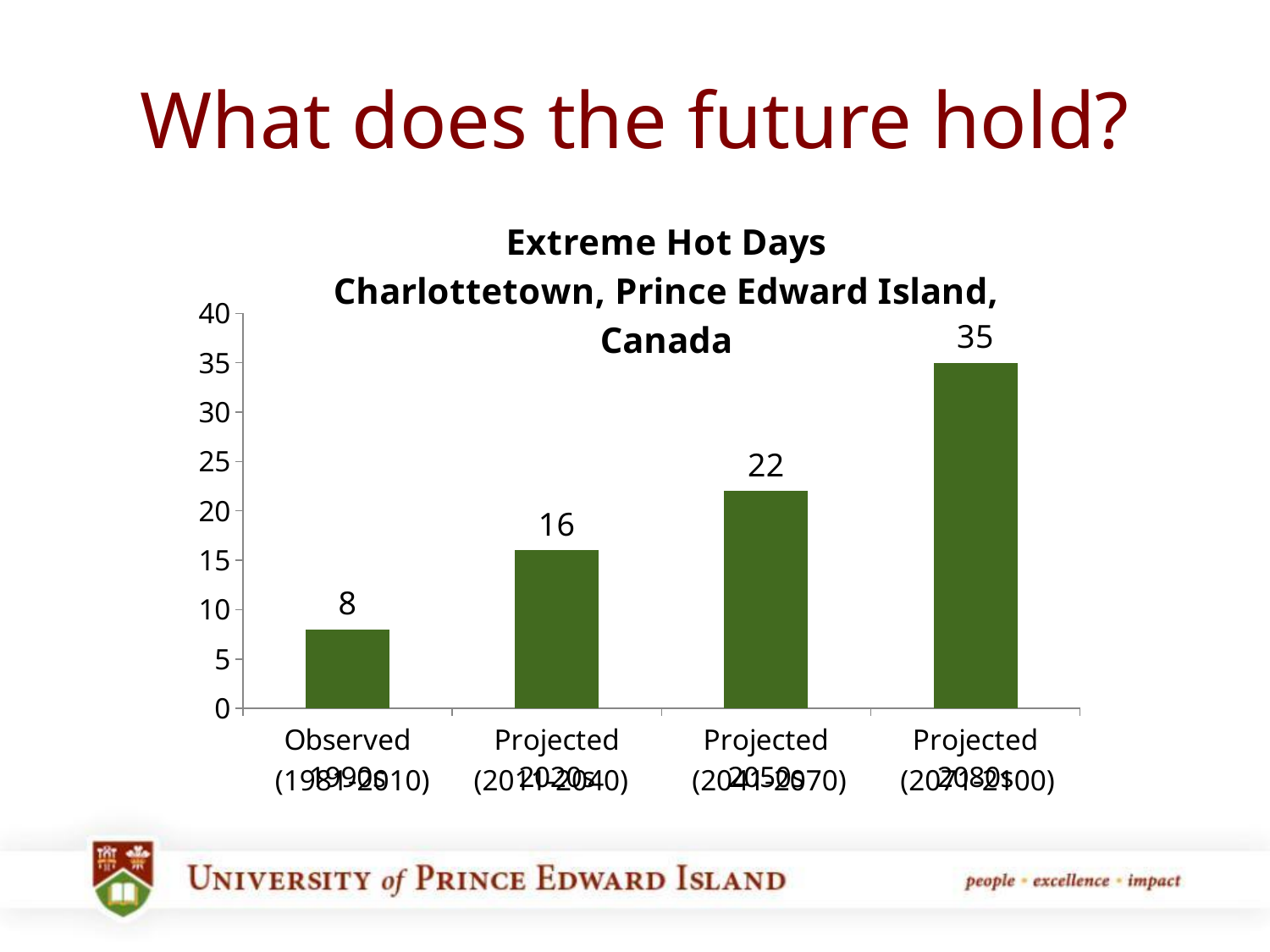
What type of chart is shown on the slide? bar chart Which is larger, the second bar or the third bar? the third bar (22) What is the difference between the fourth bar (35) and the Observed bar (8)? 27 What is the value of the third bar, Projected (2041-2070)? 22 What is the value of the fourth bar, Projected (2071-2100)? 35 How many bars are plotted in the chart? 4 What is the title of the chart? Extreme Hot Days Charlottetown, Prince Edward Island, Canada What is the value of the second bar, Projected (2011-2040)? 16 Do the values rise or fall from left to right across the bars? rise What is the value of the Observed bar (first bar)? 8 Which bar has the lowest value? Observed (1981-2010) Which bar has the highest value? Projected (2071-2100)